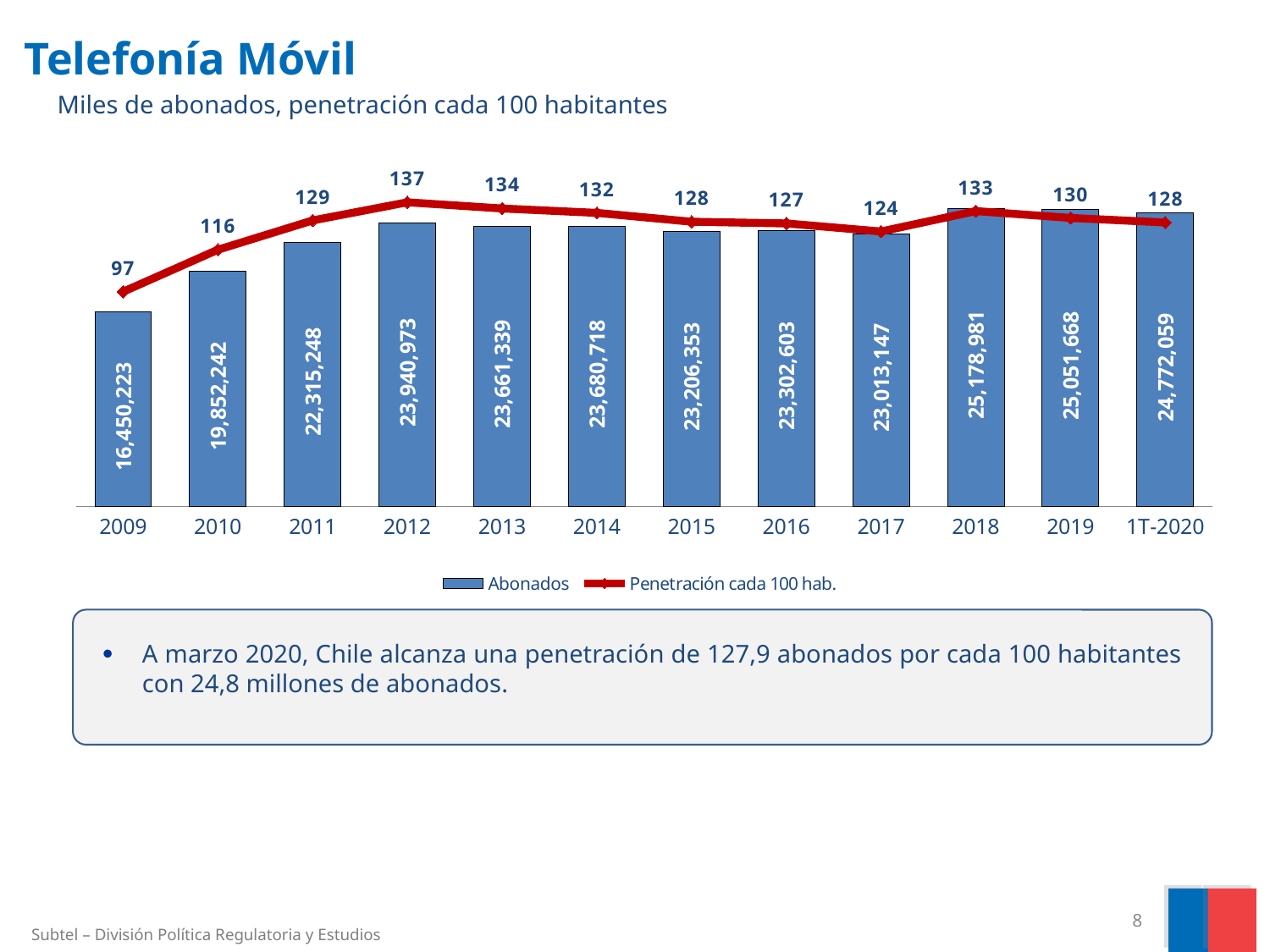
Which is larger, the Abonados value for 2013 or for 2014? 2014 What is the Abonados value for 2012? 23,940,973 What is the Penetración cada 100 hab. value for 2017? 124 Which year has the highest Abonados value? 2018 Which year has the highest Penetración cada 100 hab. value? 2012 What is the difference in Abonados between 2018 and 2019? 127,313 What is the difference in Penetración cada 100 hab. between 2012 and 2009? 40 What is the Abonados value for 1T-2020? 24,772,059 How many categories are shown on the x axis? 12 How many series does the legend list? 2 Which year has the lowest Penetración cada 100 hab. value? 2009 What kind of chart is shown on the slide? Combined bar and line chart